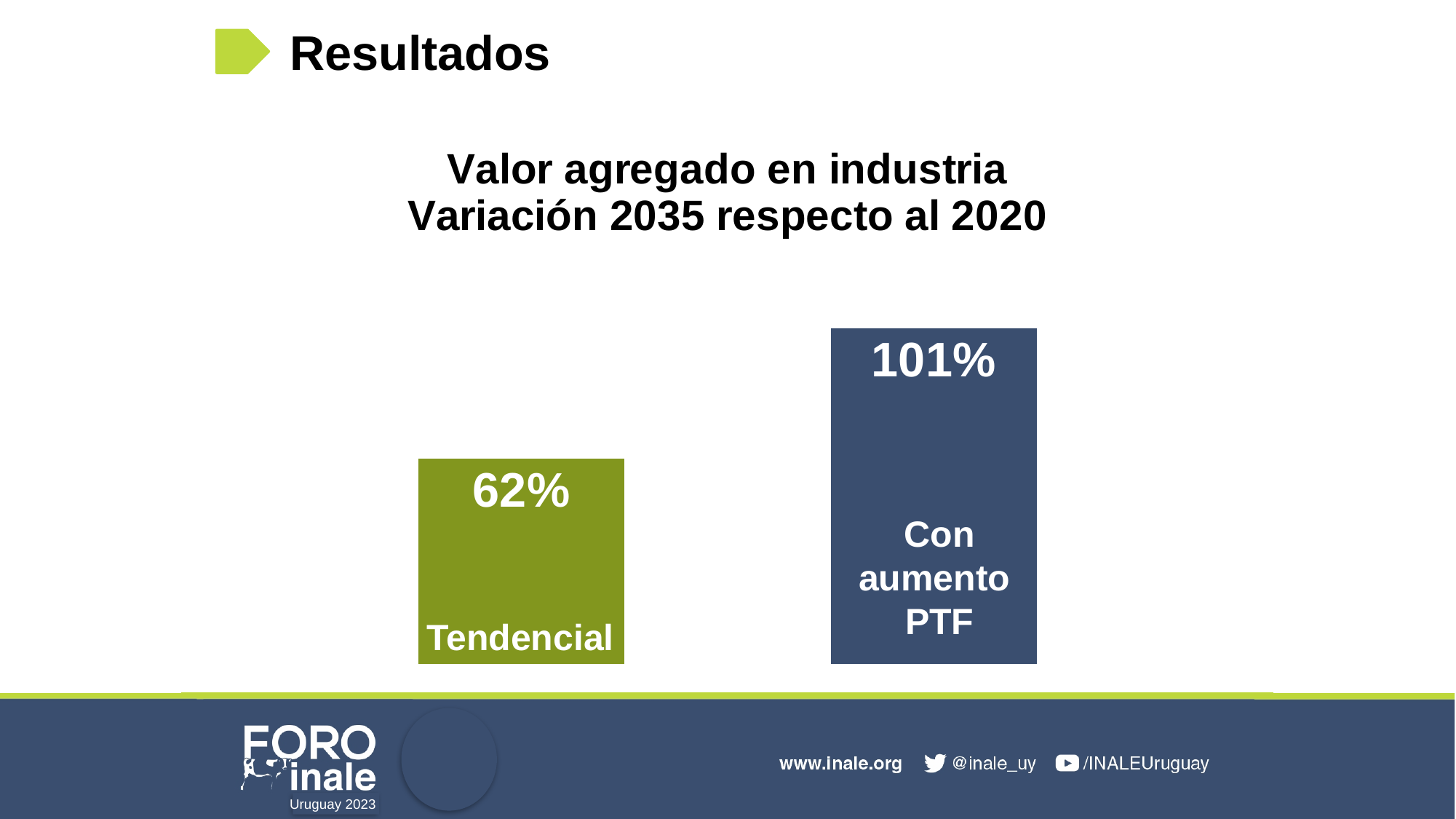
What colour is the bar for Tendencial? Green What kind of chart is shown on the slide? Bar chart Which is larger, the value for Tendencial or the value for Con aumento PTF? Con aumento PTF Is the value for Con aumento PTF greater or less than 100%? greater What is the value for Con aumento PTF? 101% What is the value for Tendencial? 62% What is the title of the chart? Valor agregado en industria Variación 2035 respecto al 2020 Which category has the lowest value? Tendencial How many categories are shown in the chart? 2 What is the difference between the values for Con aumento PTF and Tendencial? 39% Which category has the highest value? Con aumento PTF